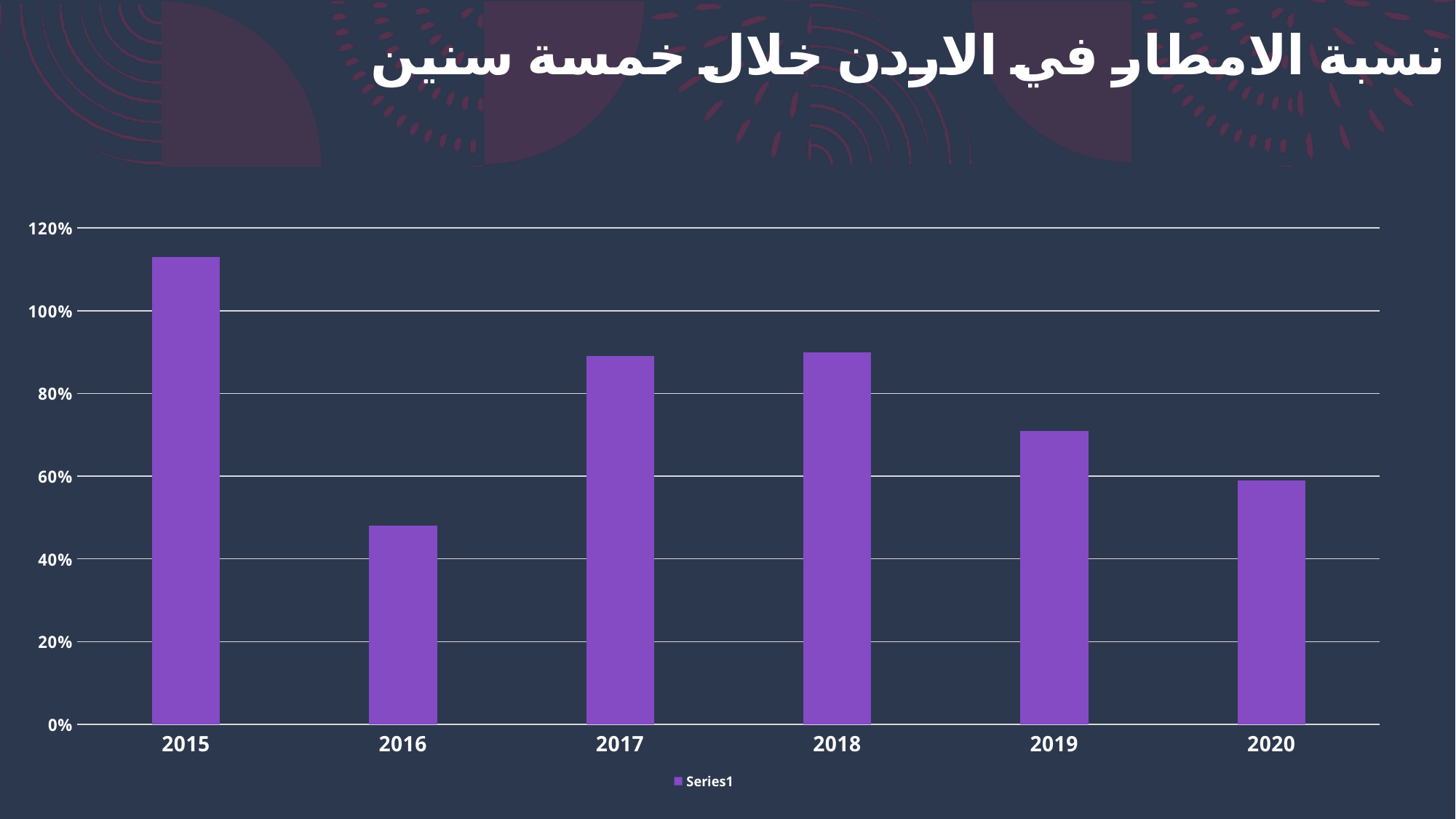
Which year has the highest bar? 2015 What kind of chart is shown on the slide? bar chart Is the value for 2019 greater or less than 80%? less Which is larger, the value for 2019 or the value for 2020? 2019 Is the value for 2016 greater or less than 60%? less Is the value for 2015 greater or less than 100%? greater How many series does the legend list? 1 Which is larger, the value for 2016 or the value for 2018? 2018 Which year has the lowest bar? 2016 How many years are shown on the x axis of the chart? 6 What is the name of the series shown in the legend? Series1